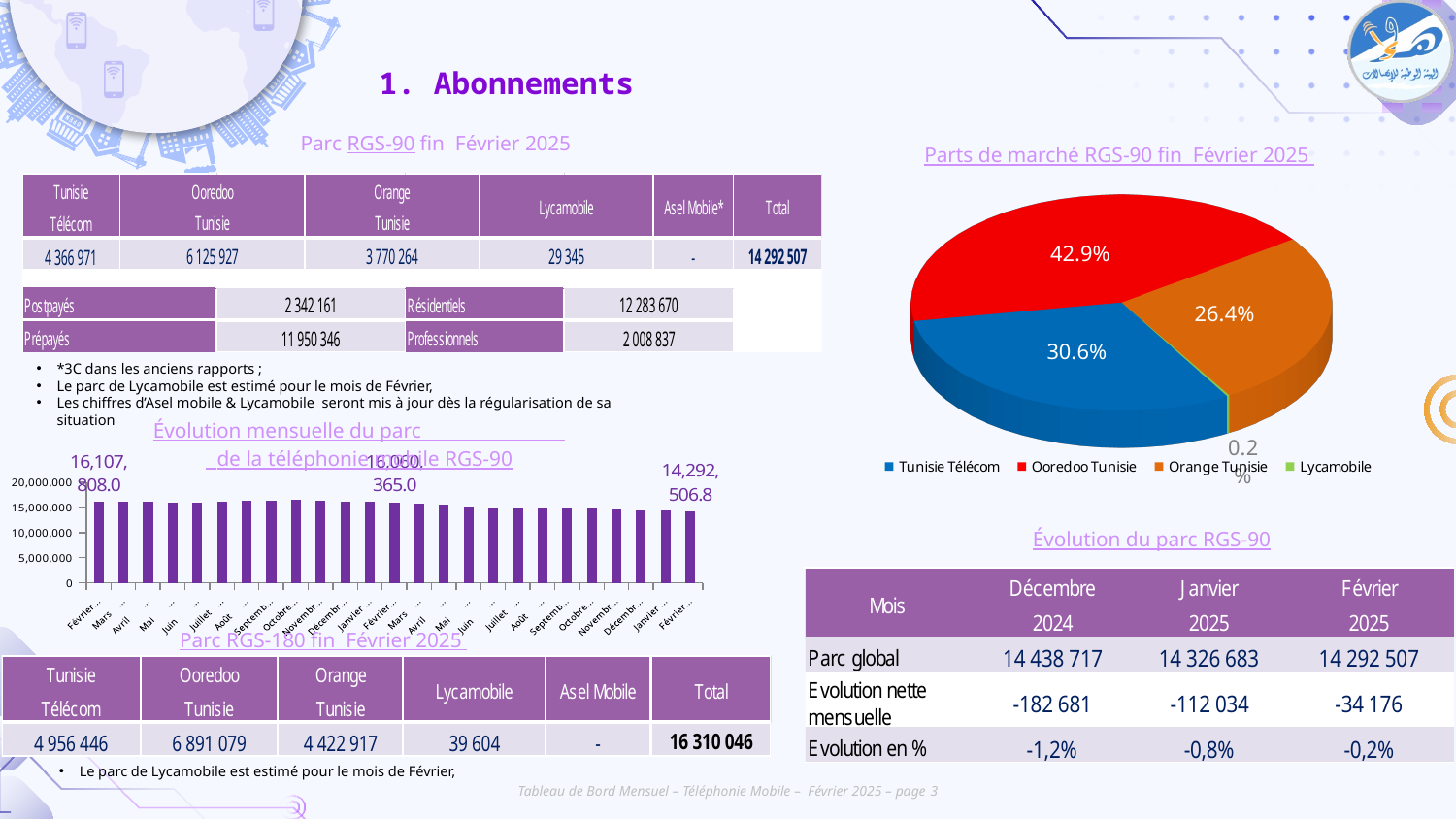
In the pie chart 'Parts de marché RGS-90 fin Février 2025', what share does Ooredoo Tunisie hold? 42.9% In the pie chart 'Parts de marché RGS-90 fin Février 2025', what share does Orange Tunisie hold? 26.4% In the pie chart 'Parts de marché RGS-90 fin Février 2025', what share does Tunisie Télécom hold? 30.6% In the pie chart 'Parts de marché RGS-90 fin Février 2025', which colour represents Tunisie Télécom? Blue In the pie chart 'Parts de marché RGS-90 fin Février 2025', which operator has the largest share? Ooredoo Tunisie In the pie chart 'Parts de marché RGS-90 fin Février 2025', how many operators does the legend list? 4 In the bar chart 'Évolution mensuelle du parc de la téléphonie mobile RGS-90', what is the value labelled on the last bar (Février)? 14,292,506.8 In the pie chart 'Parts de marché RGS-90 fin Février 2025', what is the difference between the shares of Ooredoo Tunisie and Orange Tunisie? 16.5% In the bar chart 'Évolution mensuelle du parc de la téléphonie mobile RGS-90', do the values generally rise or fall from left to right? Fall In the bar chart 'Évolution mensuelle du parc de la téléphonie mobile RGS-90', what is the value labelled on the first bar (Février)? 16,107,808.0 In the pie chart 'Parts de marché RGS-90 fin Février 2025', which operator has the smallest share? Lycamobile What kind of chart is 'Évolution mensuelle du parc de la téléphonie mobile RGS-90'? Bar chart